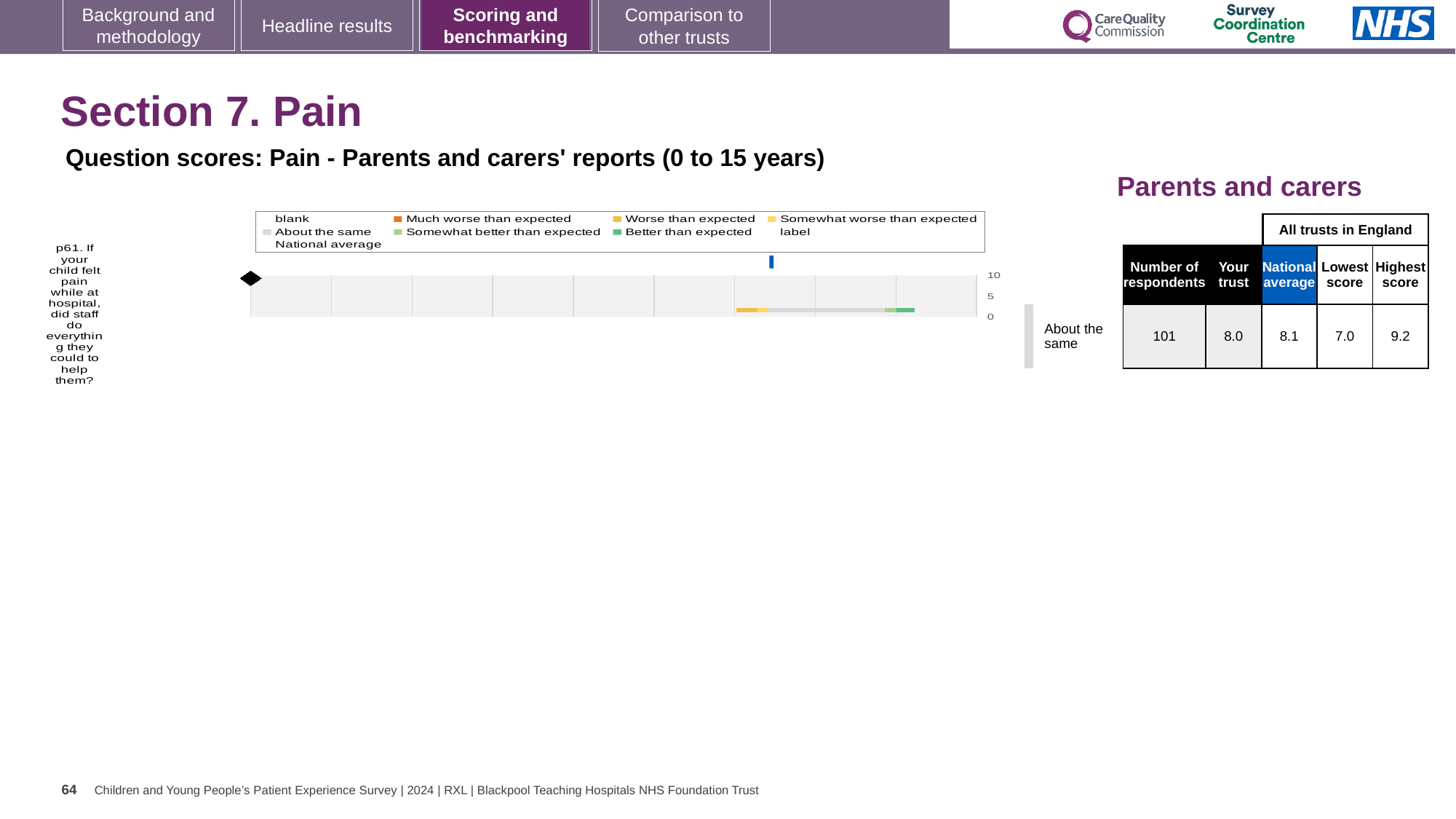
What colour does the legend use for 'Better than expected'? green According to the table next to the chart, what is the highest score among all trusts in England for question p61? 9.2 What is the difference between the highest score (9.2) and the lowest score (7.0) for question p61? 2.2 Is the national average marker for question p61 greater or less than 5 on the chart's axis? greater According to the table next to the chart, what is the national average score for question p61? 8.1 How many entries does the chart legend list? 9 Which is larger for question p61: the 'Your trust' score or the national average? National average According to the table next to the chart, how many respondents answered question p61? 101 According to the table next to the chart, what is the 'Your trust' score for question p61? 8.0 What colour does the legend use for 'Much worse than expected'? orange What kind of chart is shown on the slide? bar chart How many survey questions are plotted in the chart? 1